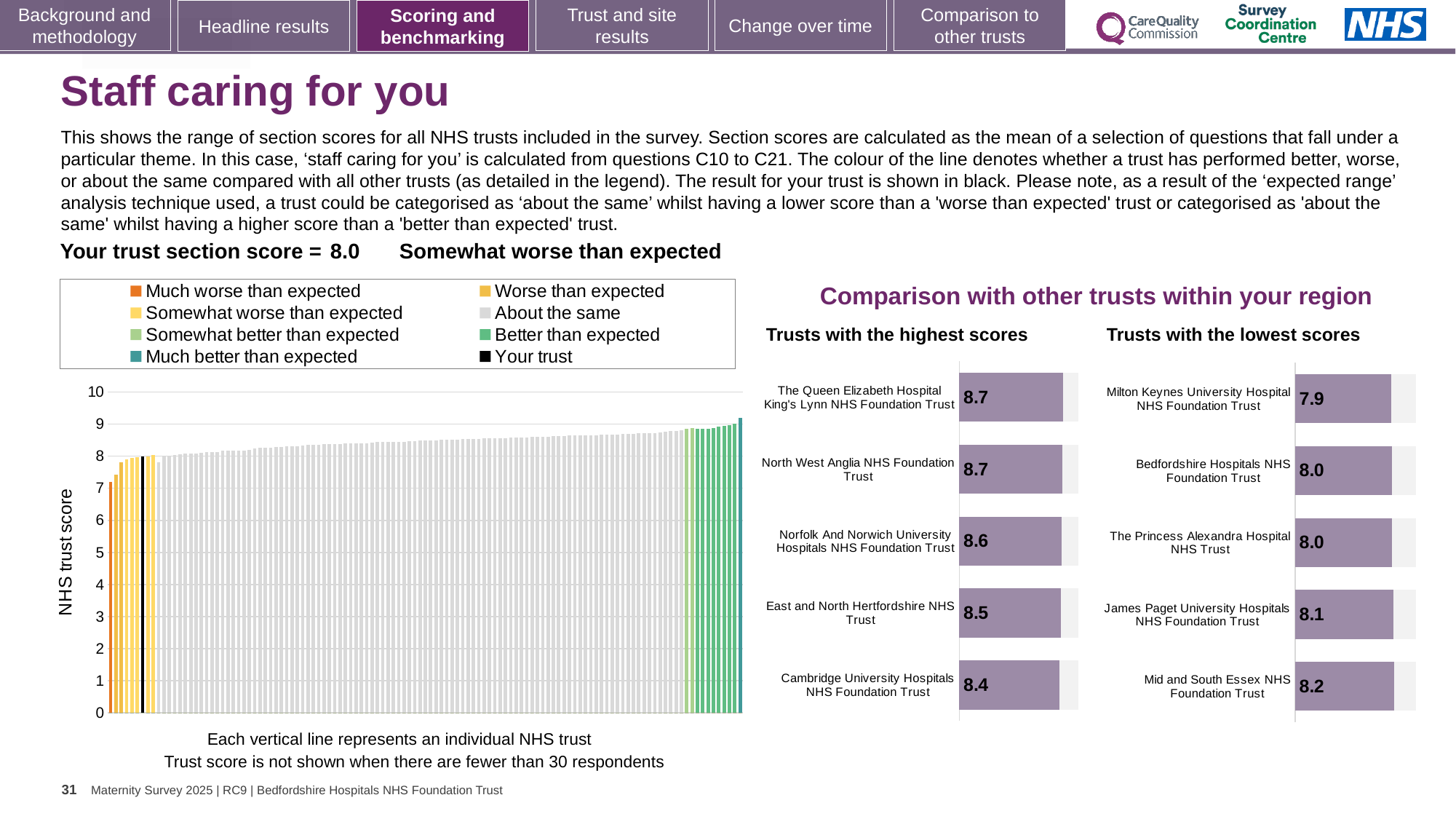
In the 'Trusts with the highest scores' chart, which trust has the lowest score? Cambridge University Hospitals NHS Foundation Trust In the 'Trusts with the lowest scores' chart, which trust has the lowest score? Milton Keynes University Hospital NHS Foundation Trust In the 'Trusts with the lowest scores' chart, what is the difference between the scores of Mid and South Essex NHS Foundation Trust and Milton Keynes University Hospital NHS Foundation Trust? 0.3 How many trusts are shown in the 'Trusts with the highest scores' chart? 5 In the 'Trusts with the highest scores' chart, what is the score for Cambridge University Hospitals NHS Foundation Trust? 8.4 In the 'Trusts with the lowest scores' chart, what is the score for Milton Keynes University Hospital NHS Foundation Trust? 7.9 What is the y-axis label of the large chart on the left? NHS trust score How many entries does the legend above the left-hand chart list? 8 In the 'Trusts with the highest scores' chart, what is the difference between the scores of The Queen Elizabeth Hospital King's Lynn NHS Foundation Trust and Cambridge University Hospitals NHS Foundation Trust? 0.3 In the 'Trusts with the highest scores' chart, which has the higher score: Norfolk And Norwich University Hospitals NHS Foundation Trust or East and North Hertfordshire NHS Trust? Norfolk And Norwich University Hospitals NHS Foundation Trust In the 'Trusts with the lowest scores' chart, which trust has the highest score? Mid and South Essex NHS Foundation Trust What kind of chart is the large chart on the left showing NHS trust scores? Bar chart